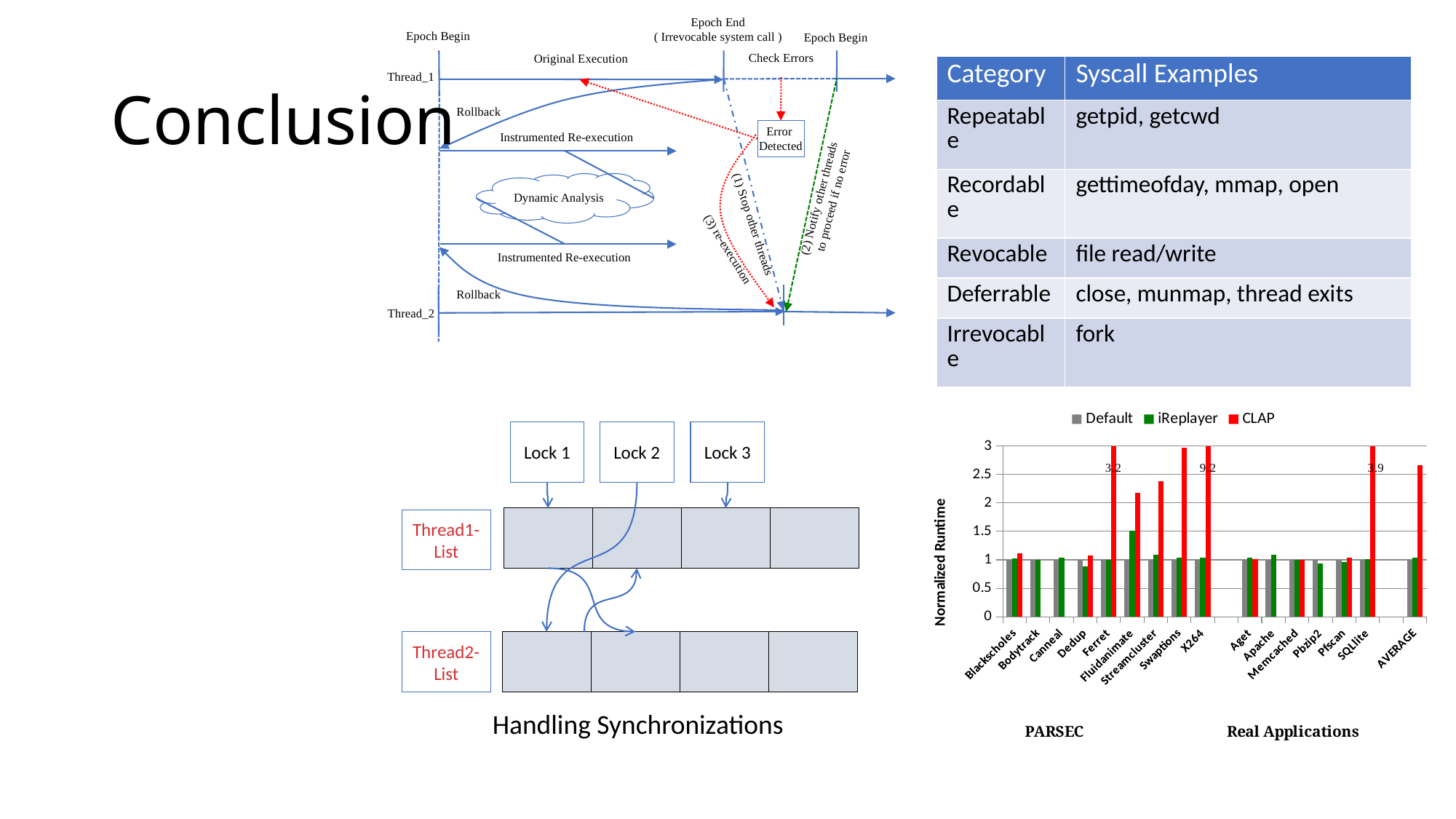
Is the iReplayer value for Fluidanimate greater or less than 1? greater How many categories are shown along the x axis of the chart? 16 Which category has the highest CLAP value? X264 Is the CLAP value for AVERAGE greater or less than 2.5? greater What is the label of the chart's y axis? Normalized Runtime For Swaptions, which is larger: the CLAP value or the iReplayer value? CLAP What kind of chart is shown on the slide? bar chart How many series does the chart's legend list? 3 Is the CLAP value for Fluidanimate greater or less than 2? greater What is the CLAP value for SQLite? 3.9